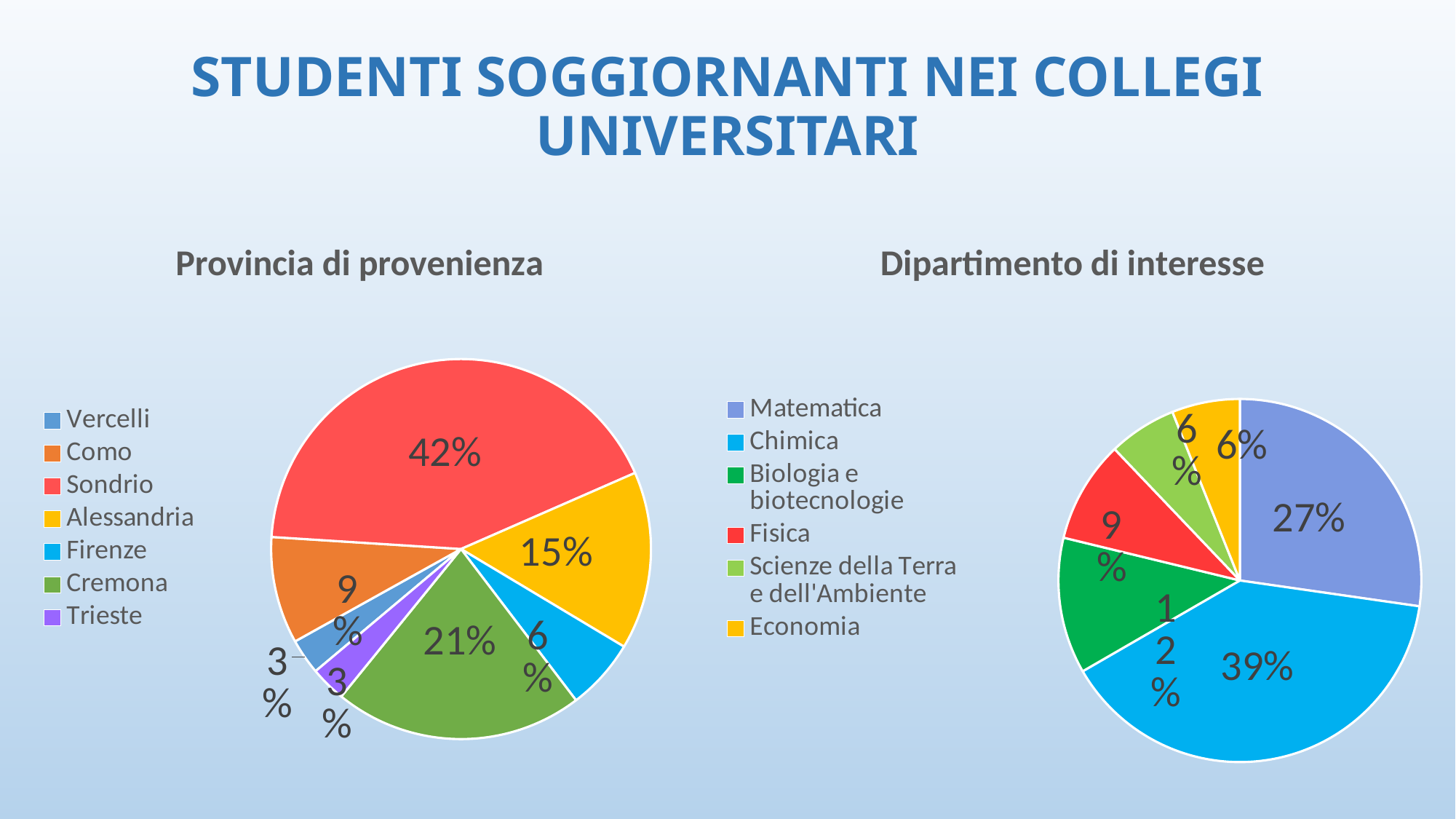
In the 'Provincia di provenienza' chart, what share of students come from Cremona? 21% In the 'Provincia di provenienza' chart, what is the difference between the shares for Alessandria and Firenze? 9% In the 'Dipartimento di interesse' chart, how many departments are listed in the legend? 6 In the 'Provincia di provenienza' chart, which province has the largest share? Sondrio In the 'Dipartimento di interesse' chart, which department has the largest share? Chimica In the 'Dipartimento di interesse' chart, what share of students are interested in Matematica? 27% What type of chart is used for 'Dipartimento di interesse'? Pie chart In the 'Dipartimento di interesse' chart, what share of students are interested in Chimica? 39% In the 'Provincia di provenienza' chart, which is larger, the share for Como or the share for Firenze? Como In the 'Provincia di provenienza' chart, how many provinces are listed in the legend? 7 In the 'Dipartimento di interesse' chart, what share of students are interested in Fisica? 9% In the 'Provincia di provenienza' chart, what share of students come from Sondrio? 42%